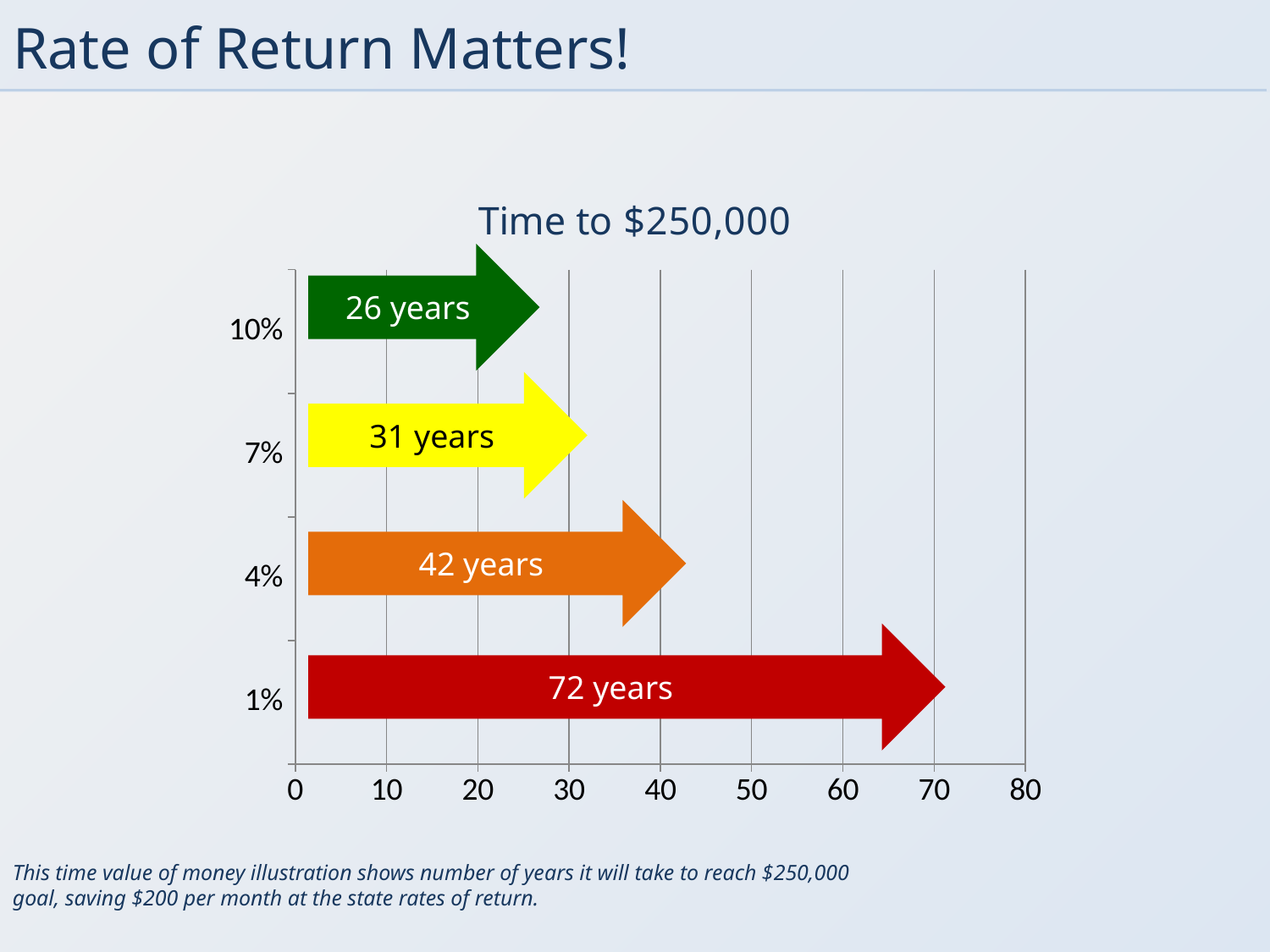
Which rate of return takes the shortest time to reach $250,000? 10% How many years does it take to reach $250,000 at a 1% rate of return? 72 years What is the title of the chart? Time to $250,000 What type of chart is shown on the slide? Bar chart How many rates of return are shown in the chart? 4 Which takes longer to reach $250,000: a 4% or a 7% rate of return? 4% How many years does it take to reach $250,000 at a 10% rate of return? 26 years What is the difference in years between the 4% and 7% rates of return? 11 years How many years does it take to reach $250,000 at a 7% rate of return? 31 years How many more years does it take to reach $250,000 at 1% than at 10%? 46 years How many years does it take to reach $250,000 at a 4% rate of return? 42 years Which rate of return takes the longest time to reach $250,000? 1%